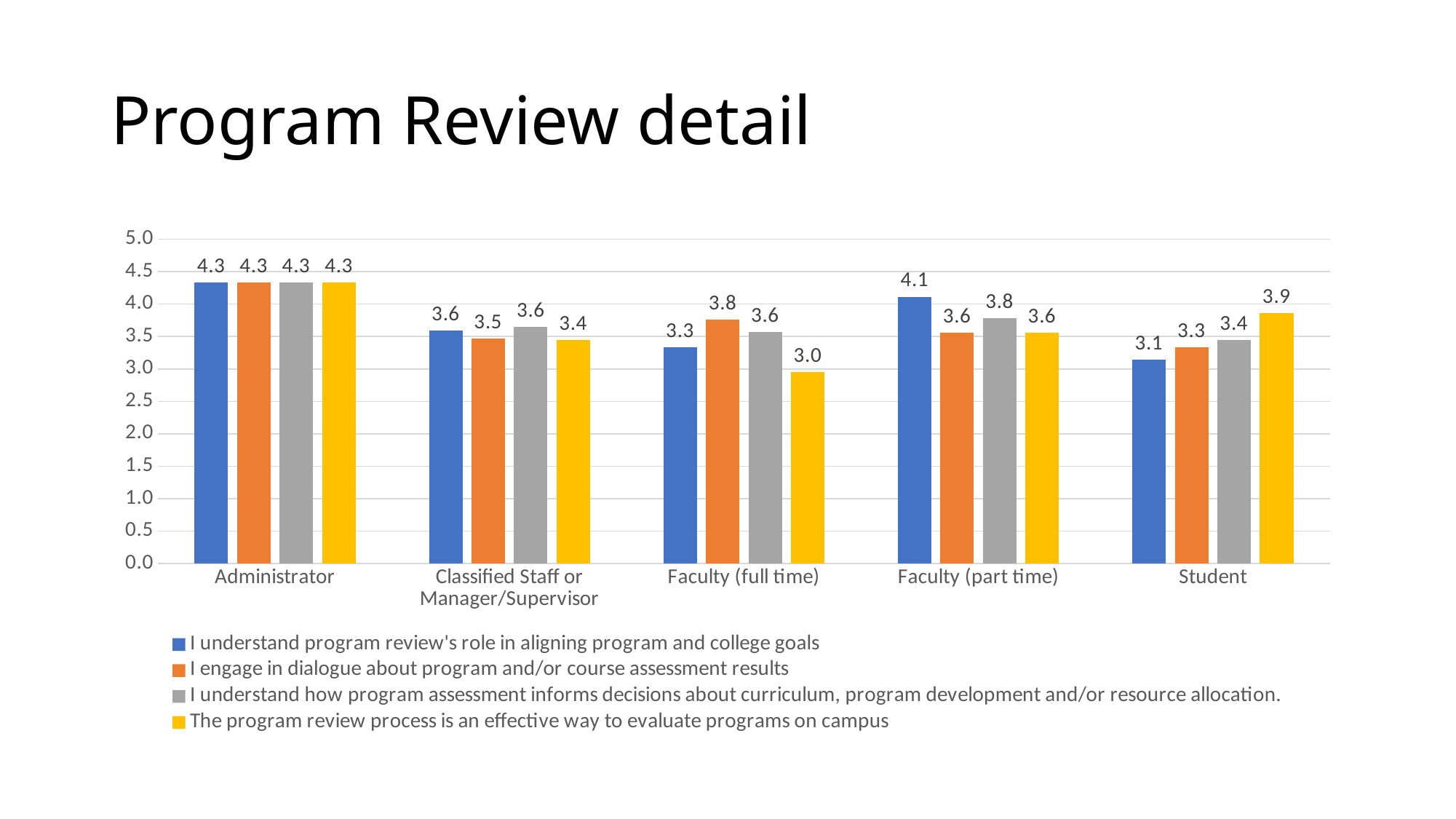
For Faculty (full time), which is larger: the value for 'I engage in dialogue about program and/or course assessment results' or the value for 'The program review process is an effective way to evaluate programs on campus'? I engage in dialogue about program and/or course assessment results Which category has the lowest value for the series 'I understand program review's role in aligning program and college goals'? Student What colour are the bars for the series 'The program review process is an effective way to evaluate programs on campus'? yellow What is the value for Faculty (full time) for the series 'I engage in dialogue about program and/or course assessment results'? 3.8 How many series does the legend list? 4 Which category has the lowest value for the series 'The program review process is an effective way to evaluate programs on campus'? Faculty (full time) What is the value for Faculty (part time) for the series 'I understand program review's role in aligning program and college goals'? 4.1 How many categories are shown on the x axis? 5 What is the value for Student for the series 'The program review process is an effective way to evaluate programs on campus'? 3.9 What kind of chart is shown on the slide? bar chart What is the difference between the Administrator and Student values for the series 'I understand program review's role in aligning program and college goals'? 1.2 Is the value for Faculty (part time) for the series 'I understand program review's role in aligning program and college goals' greater or less than 4.0? greater